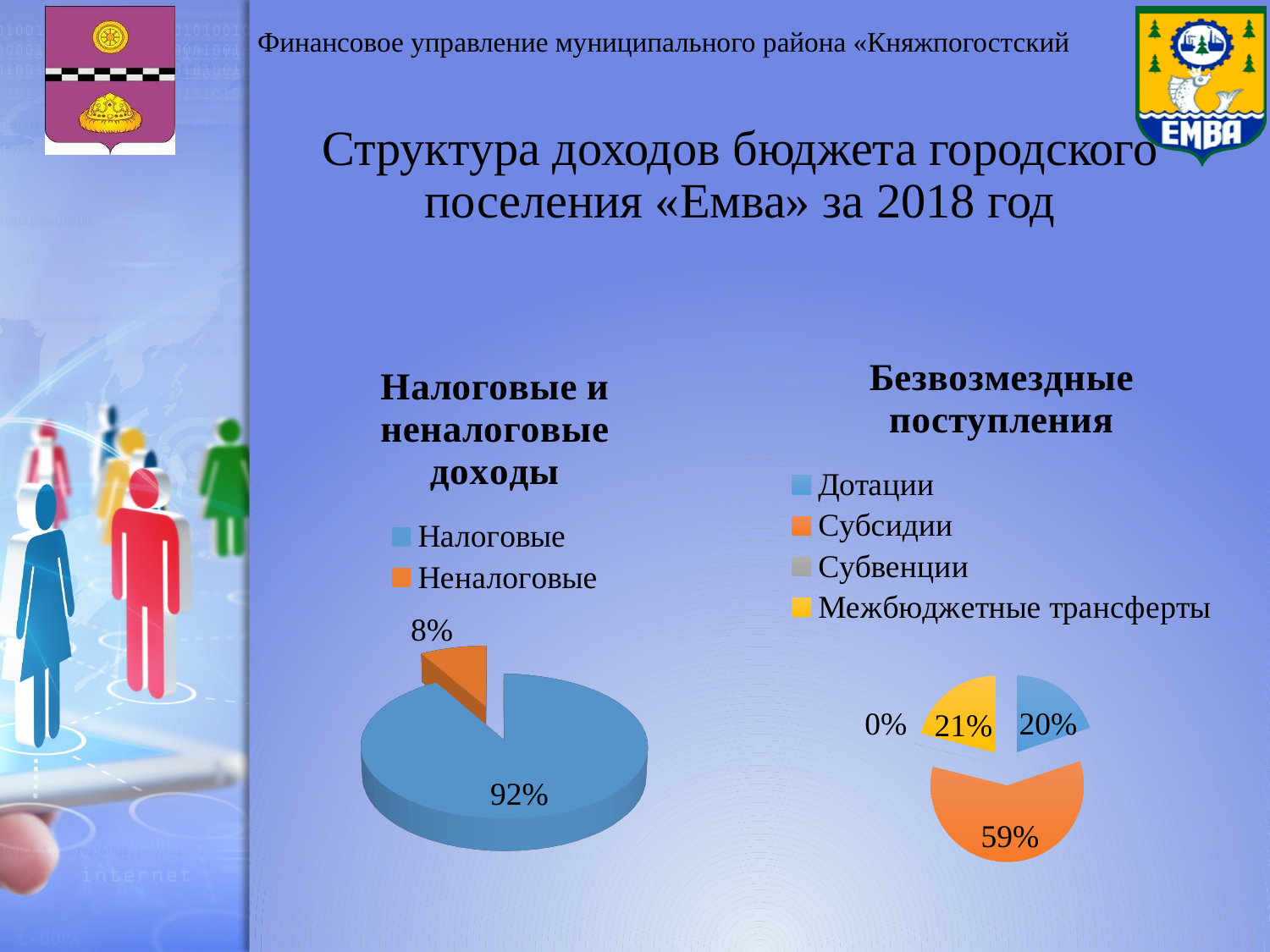
In the chart titled «Безвозмездные поступления», what share is labelled for Субсидии? 59% In the chart titled «Безвозмездные поступления», what is the difference between the Субсидии and Дотации shares? 39% In the chart titled «Безвозмездные поступления», what share is labelled for Дотации? 20% In the chart titled «Безвозмездные поступления», which category has the smallest share? Субвенции In the chart titled «Налоговые и неналоговые доходы», what share is labelled for Налоговые? 92% In the chart titled «Безвозмездные поступления», which category has the largest share? Субсидии In the chart titled «Налоговые и неналоговые доходы», what kind of chart is shown? Pie chart In the chart titled «Налоговые и неналоговые доходы», how many entries does the legend list? 2 In the chart titled «Безвозмездные поступления», what share is labelled for Межбюджетные трансферты? 21% In the chart titled «Безвозмездные поступления», how many categories does the legend list? 4 In the chart titled «Налоговые и неналоговые доходы», what share is labelled for Неналоговые? 8% In the chart titled «Налоговые и неналоговые доходы», what is the difference between the Налоговые and Неналоговые shares? 84%